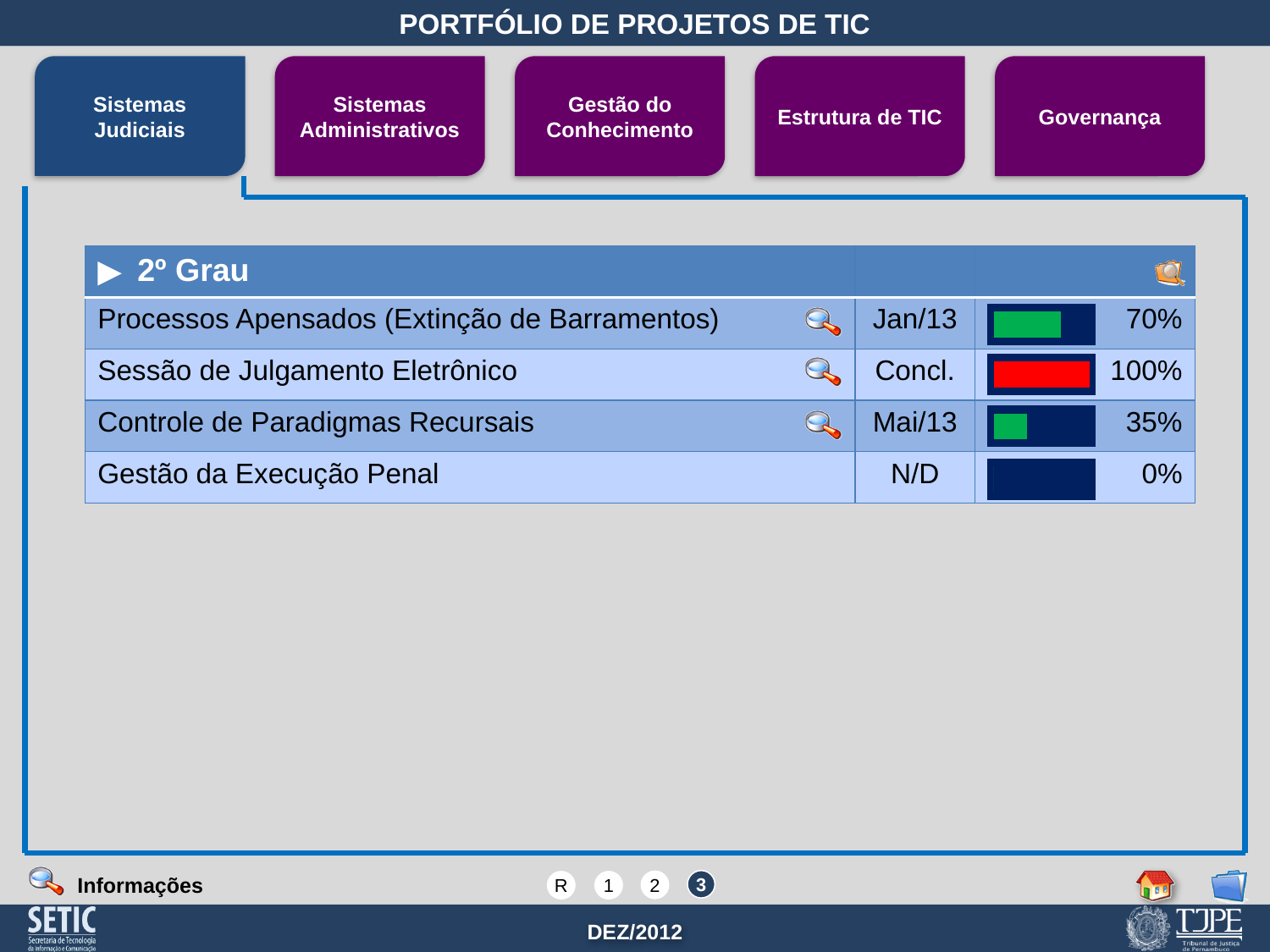
What colour is the progress bar for Sessão de Julgamento Eletrônico? Red What date is shown for Controle de Paradigmas Recursais? Mai/13 What is the difference in completion percentage between Processos Apensados (Extinção de Barramentos) and Controle de Paradigmas Recursais? 35% Which project in the 2º Grau table has the highest completion percentage? Sessão de Julgamento Eletrônico What is the completion percentage shown for Processos Apensados (Extinção de Barramentos)? 70% What kind of chart is used to show the completion percentages in the table? Bar chart What is the completion percentage shown for Gestão da Execução Penal? 0% What is the completion percentage shown for Sessão de Julgamento Eletrônico? 100% Which project in the 2º Grau table has the lowest completion percentage? Gestão da Execução Penal Which has a higher completion percentage, Controle de Paradigmas Recursais or Processos Apensados (Extinção de Barramentos)? Processos Apensados (Extinção de Barramentos) How many projects are listed in the 2º Grau table? 4 What is the completion percentage shown for Controle de Paradigmas Recursais? 35%